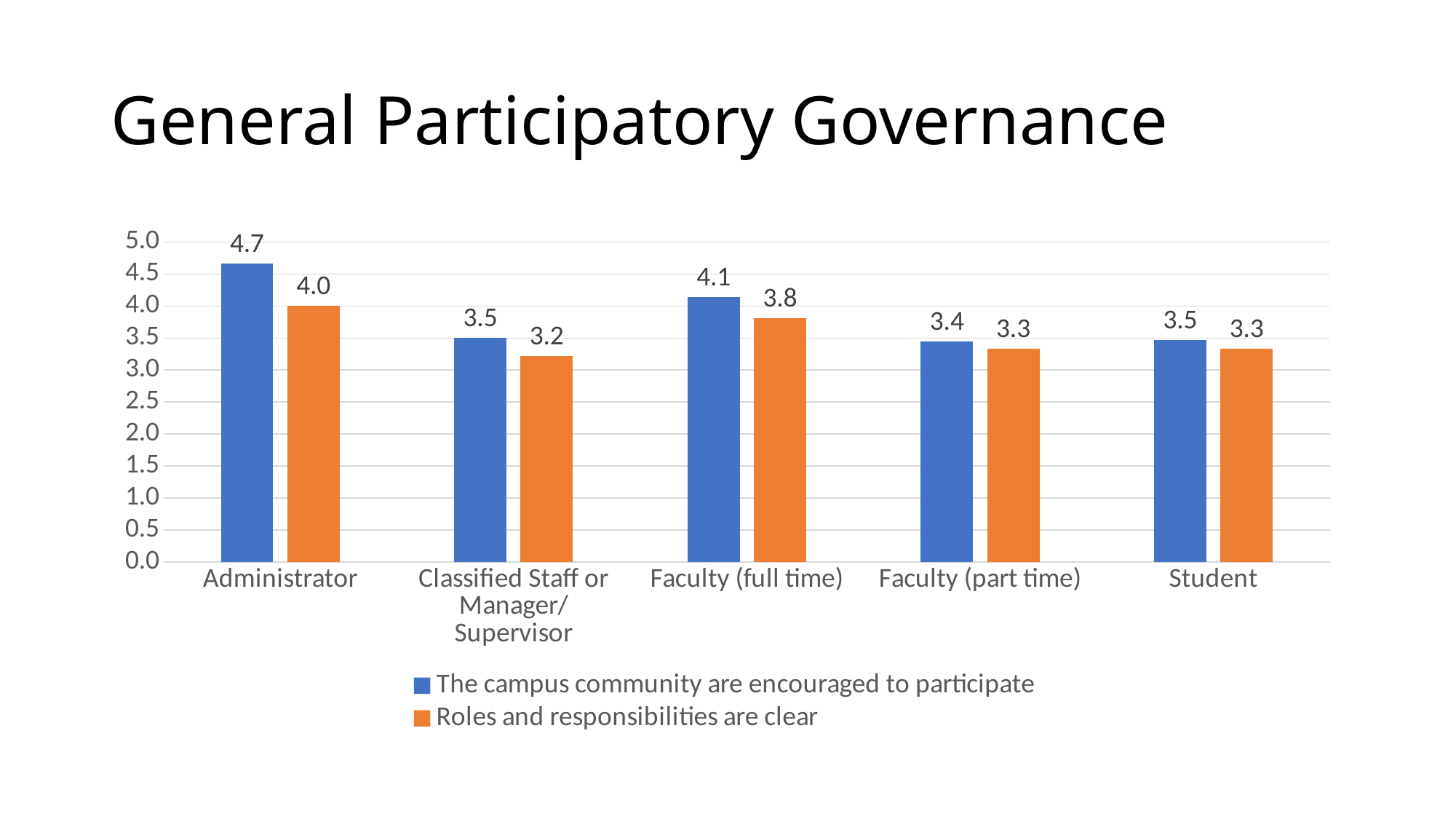
How many series does the legend list? 2 Which is larger for Faculty (full time): 'The campus community are encouraged to participate' or 'Roles and responsibilities are clear'? The campus community are encouraged to participate What is the value for Administrator in the series 'The campus community are encouraged to participate'? 4.7 What is the value for Faculty (full time) in the series 'Roles and responsibilities are clear'? 3.8 Which category has the lowest value in the series 'Roles and responsibilities are clear'? Classified Staff or Manager/Supervisor What colour are the bars for the series 'Roles and responsibilities are clear'? Orange What is the value for Student in the series 'The campus community are encouraged to participate'? 3.5 What is the difference between the two series values for Administrator? 0.7 Is the value for Faculty (part time) in the series 'Roles and responsibilities are clear' greater or less than 3.0? greater What kind of chart is shown on the slide? Bar chart How many categories are shown on the x axis? 5 Which category has the highest value in the series 'The campus community are encouraged to participate'? Administrator